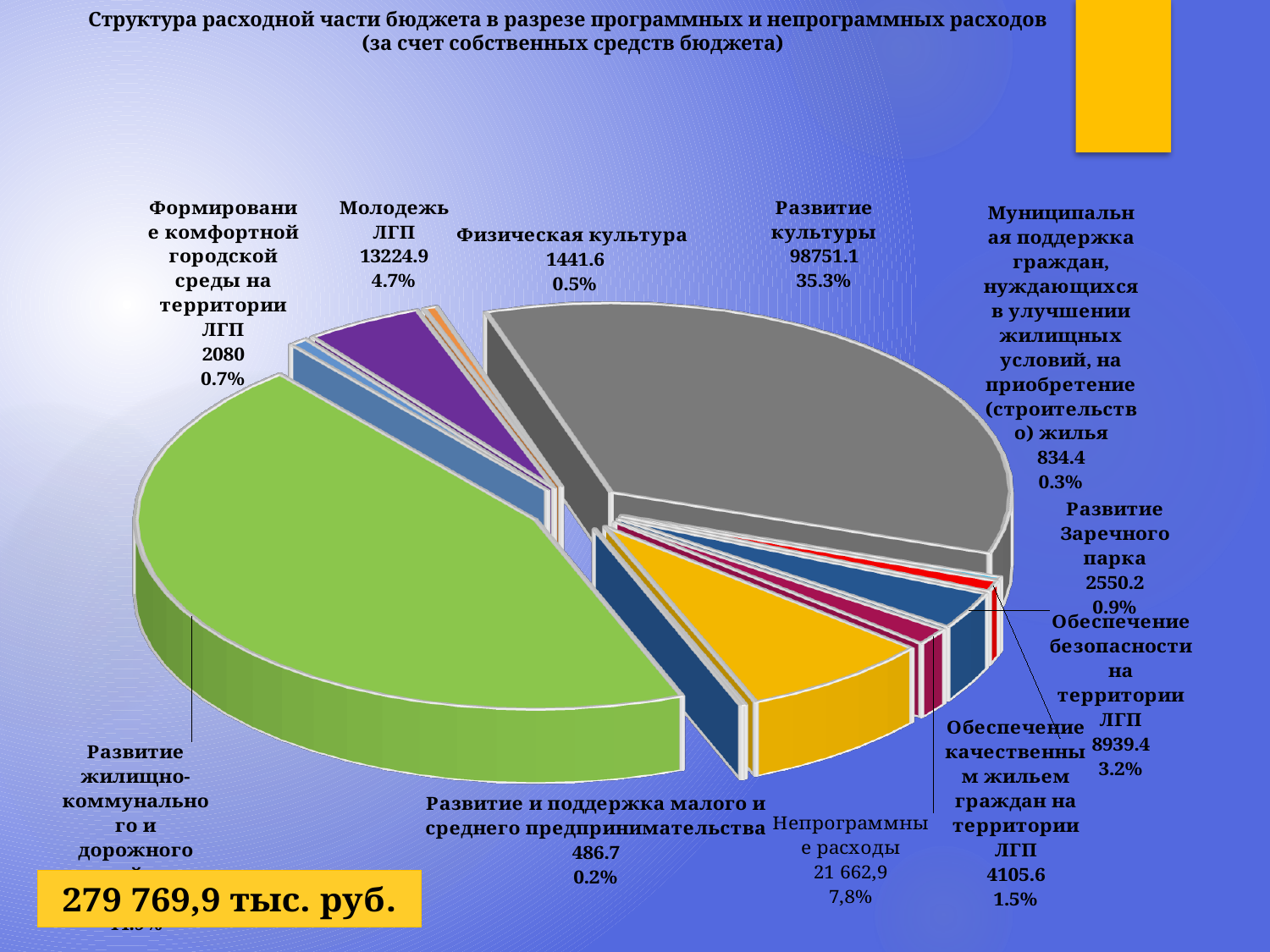
Which is larger: Обеспечение безопасности на территории ЛГП or Обеспечение качественным жильем граждан на территории ЛГП? Обеспечение безопасности на территории ЛГП What is the value for Молодежь ЛГП? 13224.9 What is the difference between the values for Развитие Заречного парка and Формирование комфортной городской среды на территории ЛГП? 470.2 What is the difference between the values for Молодежь ЛГП and Обеспечение безопасности на территории ЛГП? 4285.5 What total amount is shown in the yellow box at the bottom of the slide? 279 769,9 тыс. руб. Which category has the smallest value? Развитие и поддержка малого и среднего предпринимательства What is the value for Развитие культуры? 98751.1 What percentage is shown for Непрограммные расходы? 7,8% What share of the pie does Физическая культура take? 0.5% What kind of chart is shown on the slide? pie chart What is the value for Развитие Заречного парка? 2550.2 What share of the pie does Развитие культуры take? 35.3%